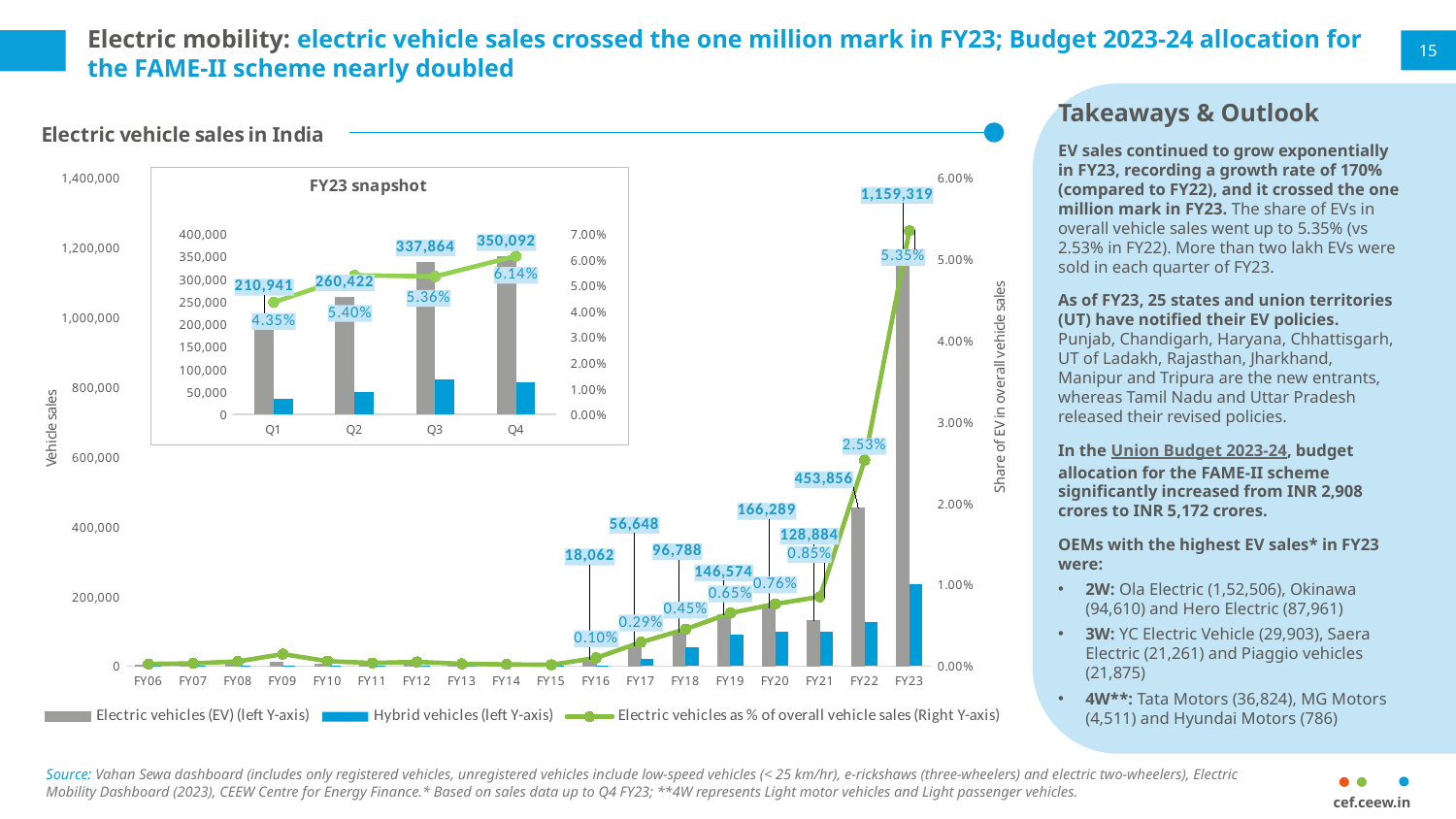
In the 'Electric vehicle sales in India' chart, what is the electric vehicle sales value labelled for FY23? 1,159,319 What kind of chart is the 'Electric vehicle sales in India' chart? Combined bar and line chart In the 'Electric vehicle sales in India' chart, how many series does the legend list? 3 In the 'Electric vehicle sales in India' chart, what is the difference between electric vehicle sales in FY23 and FY22? 705,463 In the 'FY23 snapshot' chart, which quarter has the highest electric vehicle sales? Q4 In the 'FY23 snapshot' chart, what is the difference between electric vehicle sales in Q4 and Q3? 12,228 In the 'Electric vehicle sales in India' chart, which is larger: electric vehicle sales in FY20 or FY21? FY20 In the 'Electric vehicle sales in India' chart, does the share of EVs in overall vehicle sales rise or fall from FY16 to FY23? rise In the 'Electric vehicle sales in India' chart, how many fiscal years are shown on the x axis? 18 In the 'Electric vehicle sales in India' chart, what share of overall vehicle sales did electric vehicles have in FY22? 2.53% In the 'FY23 snapshot' chart, which quarter has the lowest share of EVs in overall vehicle sales? Q1 In the 'Electric vehicle sales in India' chart, is the hybrid vehicles value for FY22 greater or less than 200,000? less